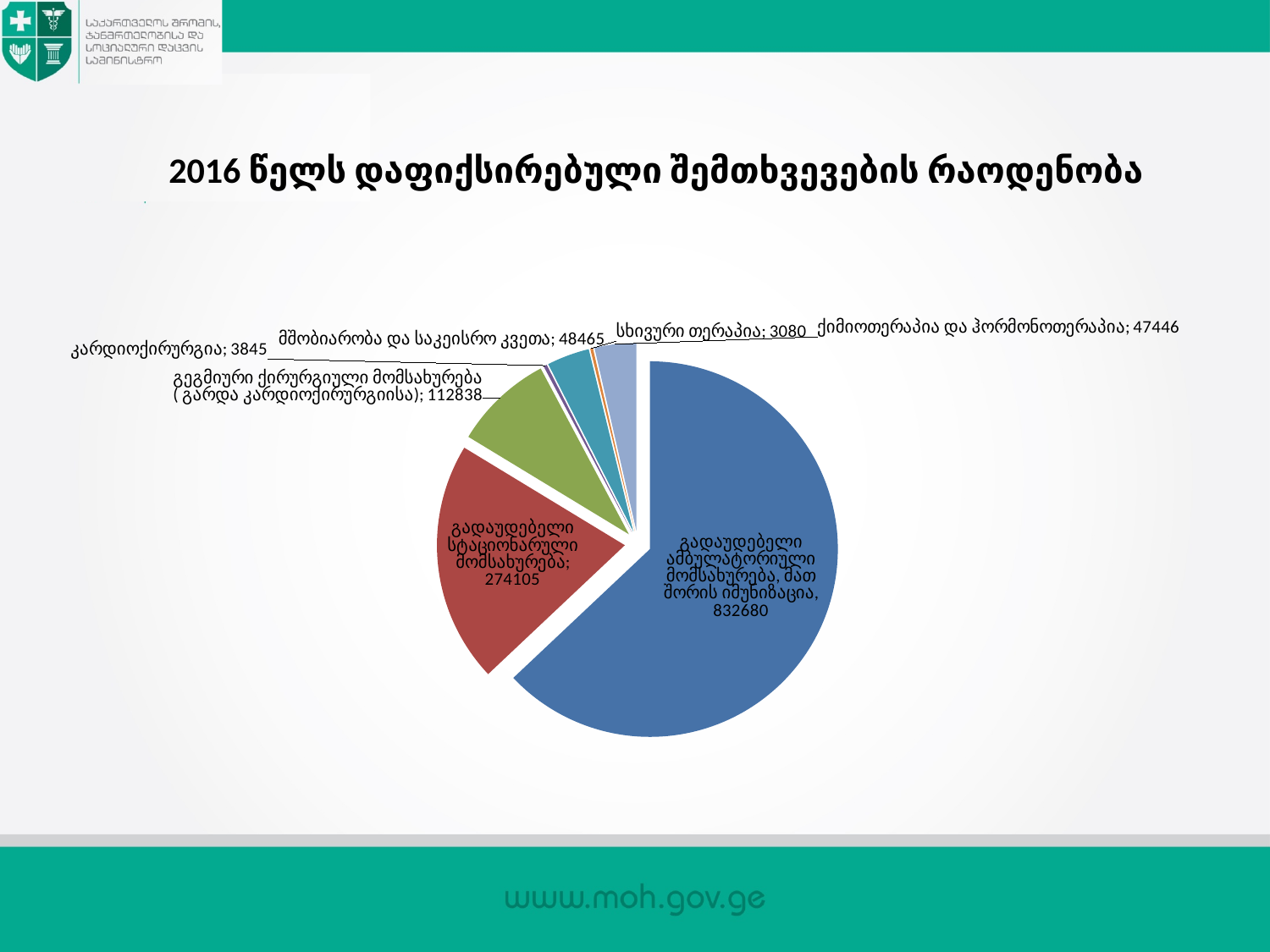
What is the value for სხივური თერაპია? 3080 What is the title of the chart on the slide? 2016 წელს დაფიქსირებული შემთხვევების რაოდენობა Which category has the largest slice of the pie? გადაუდებელი ამბულატორიული მომსახურება, მათ შორის იმუნიზაცია What type of chart is shown on the slide? pie chart What is the value for ქიმიოთერაპია და ჰორმონოთერაპია? 47446 Which is larger: the value for მშობიარობა და საკეისრო კვეთა or the value for კარდიოქირურგია? მშობიარობა და საკეისრო კვეთა Which category has the smallest value in the pie chart? სხივური თერაპია What is the value for გადაუდებელი სტაციონარული მომსახურება? 274105 What is the difference between the values for გადაუდებელი ამბულატორიული მომსახურება and გადაუდებელი სტაციონარული მომსახურება? 558575 How many slices does the pie chart have? 7 What is the value for გეგმიური ქირურგიული მომსახურება (გარდა კარდიოქირურგიისა)? 112838 What is the value for გადაუდებელი ამბულატორიული მომსახურება, მათ შორის იმუნიზაცია? 832680